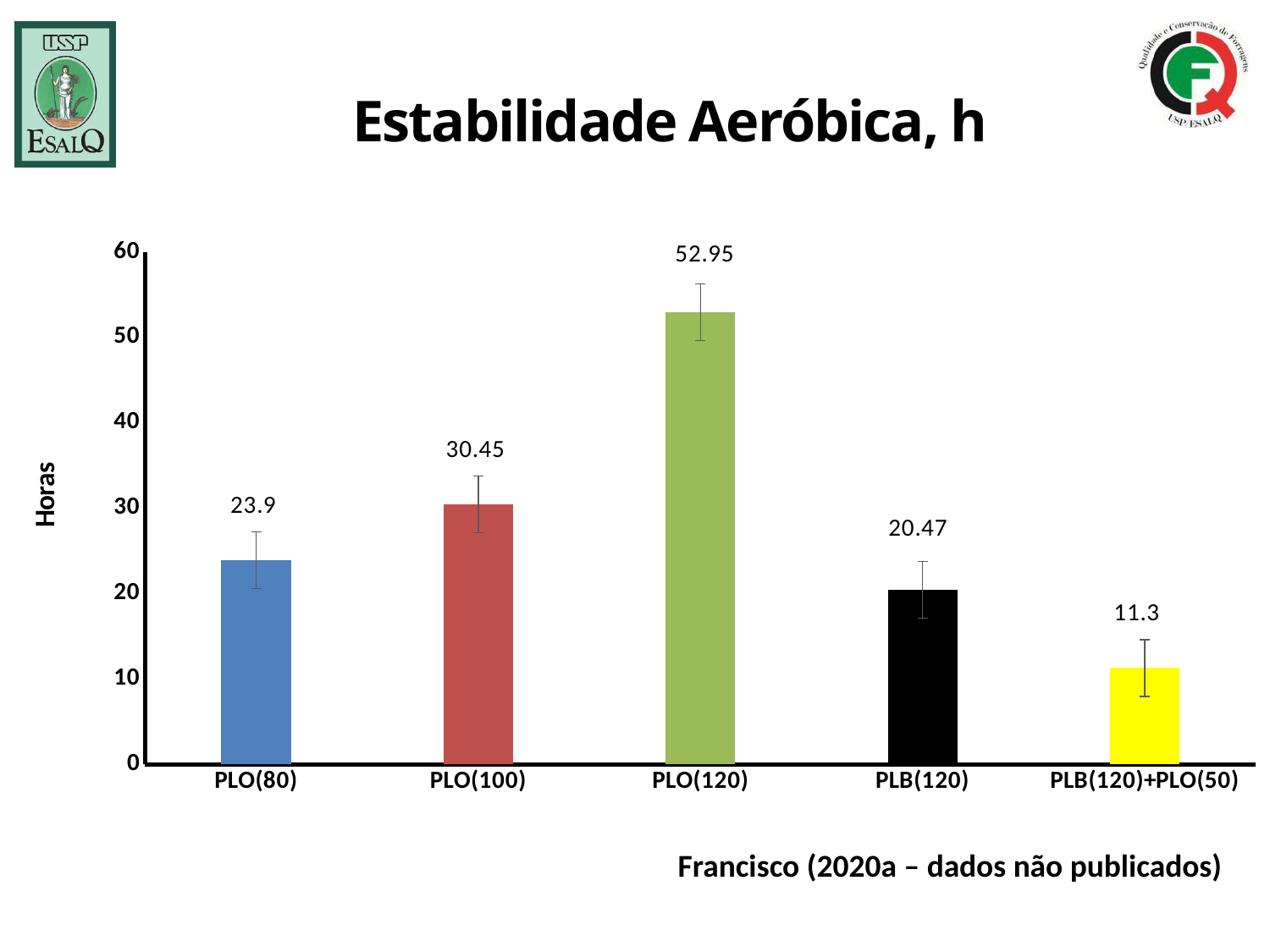
What is the label of the y axis? Horas Is the value for PLO(120) greater or less than 50? greater Which category has the highest value? PLO(120) What is the difference between the values for PLO(80) and PLB(120)? 3.43 What is the difference between the values for PLO(120) and PLO(100)? 22.5 How many categories are shown on the x axis? 5 What is the value for PLO(80)? 23.9 What is the value for PLB(120)+PLO(50)? 11.3 Which category has the lowest value? PLB(120)+PLO(50) Which is larger, the value for PLO(100) or the value for PLB(120)? PLO(100) What kind of chart is shown on the slide? bar chart What is the value for PLO(120)? 52.95